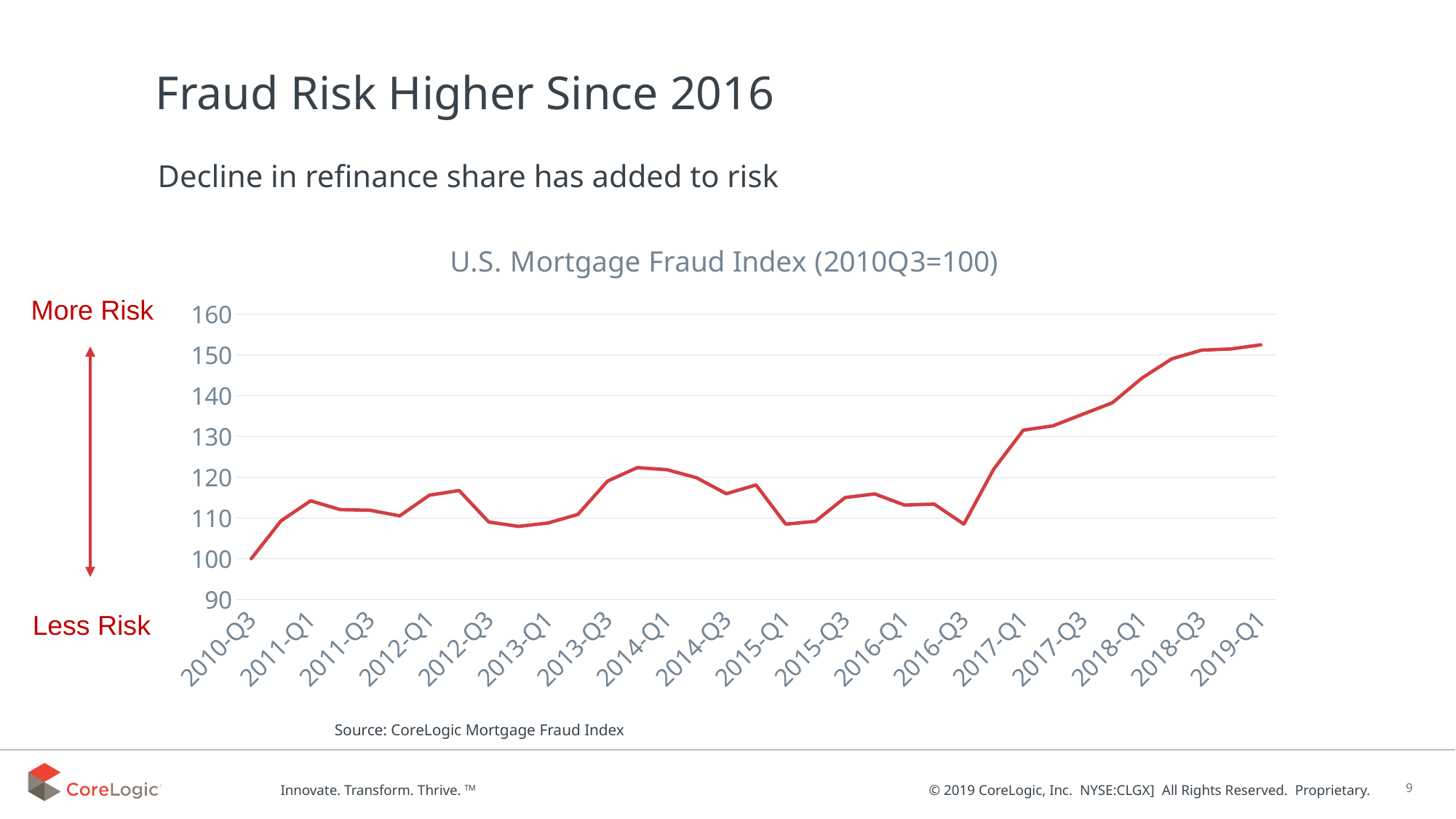
Which quarter shown on the x axis has the highest value of the index? 2019-Q1 Which quarter shown on the x axis has the lowest value of the index? 2010-Q3 Is the value for 2017-Q1 greater or less than 120? greater Is the value for 2016-Q3 greater or less than 110? less What is the value of the U.S. Mortgage Fraud Index at 2010-Q3? 100 Is the value for 2018-Q1 greater or less than 130? greater What is the chart's title? U.S. Mortgage Fraud Index (2010Q3=100) Which is larger, the index value at 2017-Q1 or at 2016-Q3? 2017-Q1 What is the highest value shown on the vertical axis? 160 Does the index generally rise or fall from 2016-Q3 to 2019-Q1? rise What kind of chart is shown on the slide? line chart